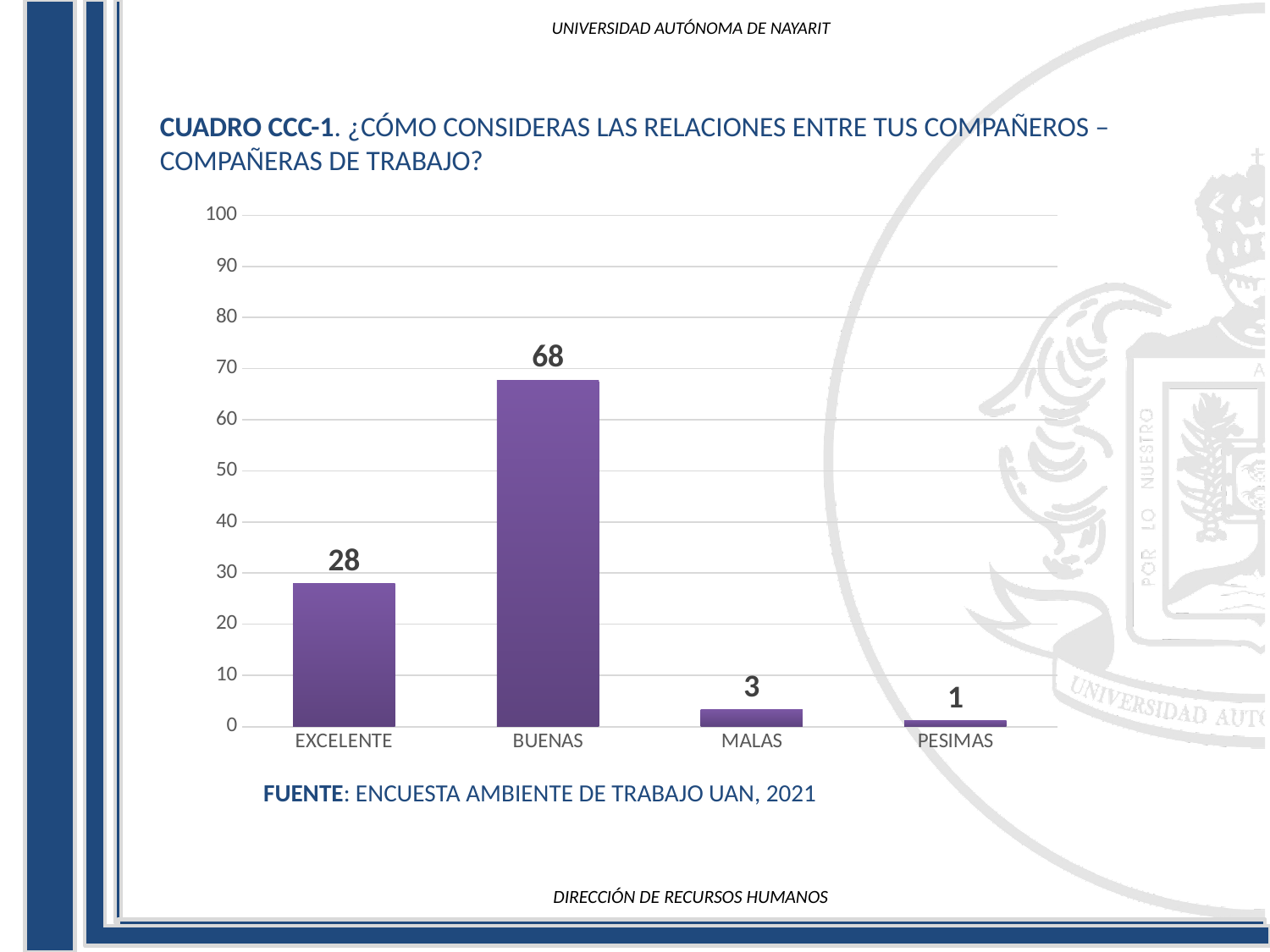
What source is cited below the chart? ENCUESTA AMBIENTE DE TRABAJO UAN, 2021 What kind of chart is shown on the slide? Bar chart What is the value for BUENAS? 68 Which is larger, the value for EXCELENTE or the value for MALAS? EXCELENTE Which category has the lowest value? PESIMAS Which category has the highest value? BUENAS Is the value for BUENAS greater or less than 60? greater How many categories are shown on the x axis? 4 What is the value for PESIMAS? 1 What is the difference between the values for BUENAS and EXCELENTE? 40 What is the value for MALAS? 3 What is the value for EXCELENTE? 28